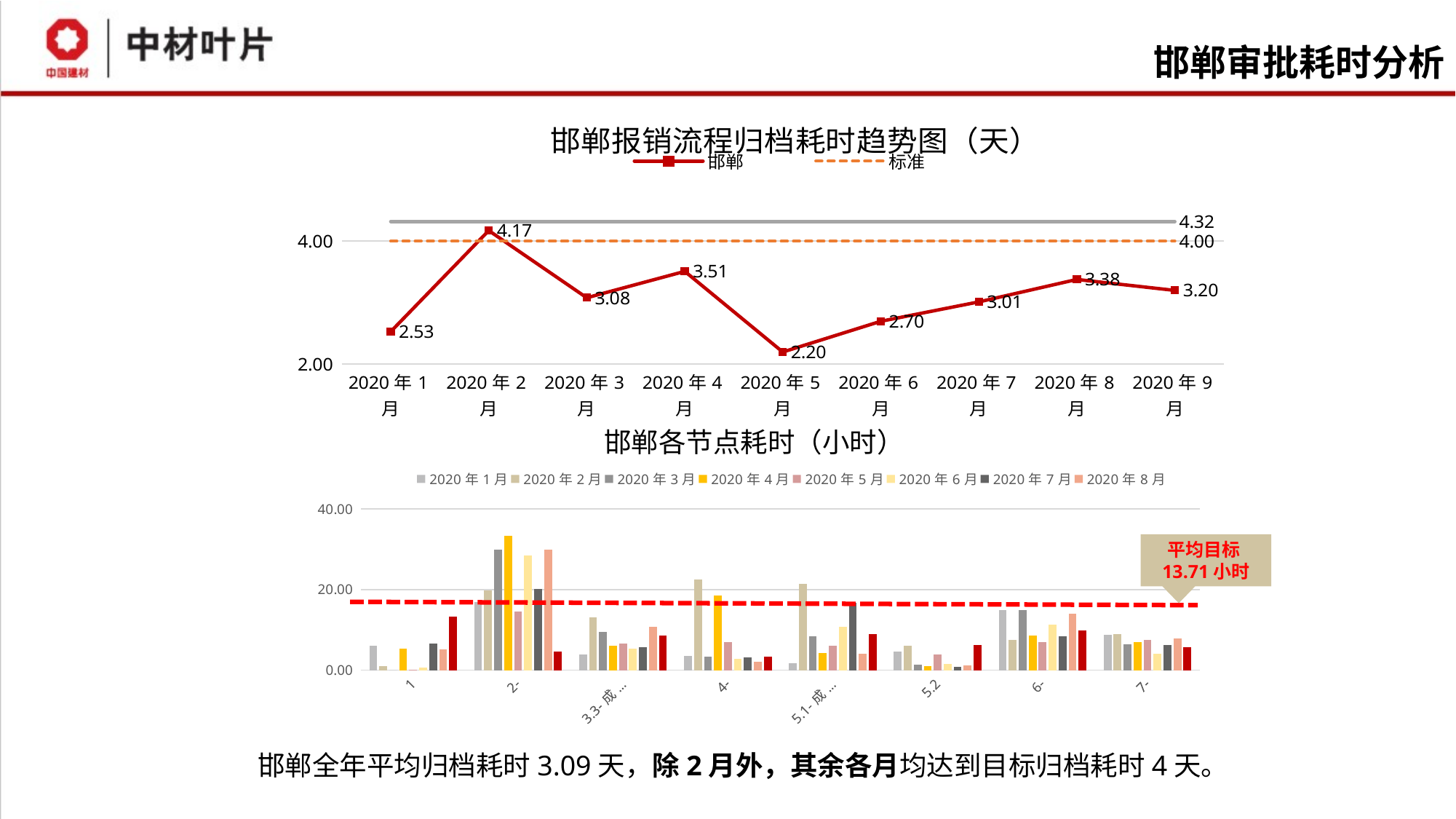
In the top chart 邯郸报销流程归档耗时趋势图（天）, what is the value for 2020年9月? 3.20 In the top chart 邯郸报销流程归档耗时趋势图（天）, what is the value for 2020年2月? 4.17 In the top chart 邯郸报销流程归档耗时趋势图（天）, what value does the dashed 标准 line sit at? 4.00 What kind of chart is the bottom chart 邯郸各节点耗时（小时）? bar chart In the top chart 邯郸报销流程归档耗时趋势图（天）, what is the value for 2020年5月? 2.20 In the top chart 邯郸报销流程归档耗时趋势图（天）, which is larger, the value for 2020年4月 or 2020年8月? 2020年4月 In the top chart 邯郸报销流程归档耗时趋势图（天）, what is the difference between the values for 2020年2月 and 2020年5月? 1.97 In the top chart 邯郸报销流程归档耗时趋势图（天）, which month has the lowest value? 2020年5月 In the top chart 邯郸报销流程归档耗时趋势图（天）, how many months are plotted on the x axis? 9 In the bottom chart 邯郸各节点耗时（小时）, what average target value is shown in the callout? 13.71 小时 In the bottom chart 邯郸各节点耗时（小时）, how many series does the legend list? 8 In the top chart 邯郸报销流程归档耗时趋势图（天）, which month has the highest value? 2020年2月